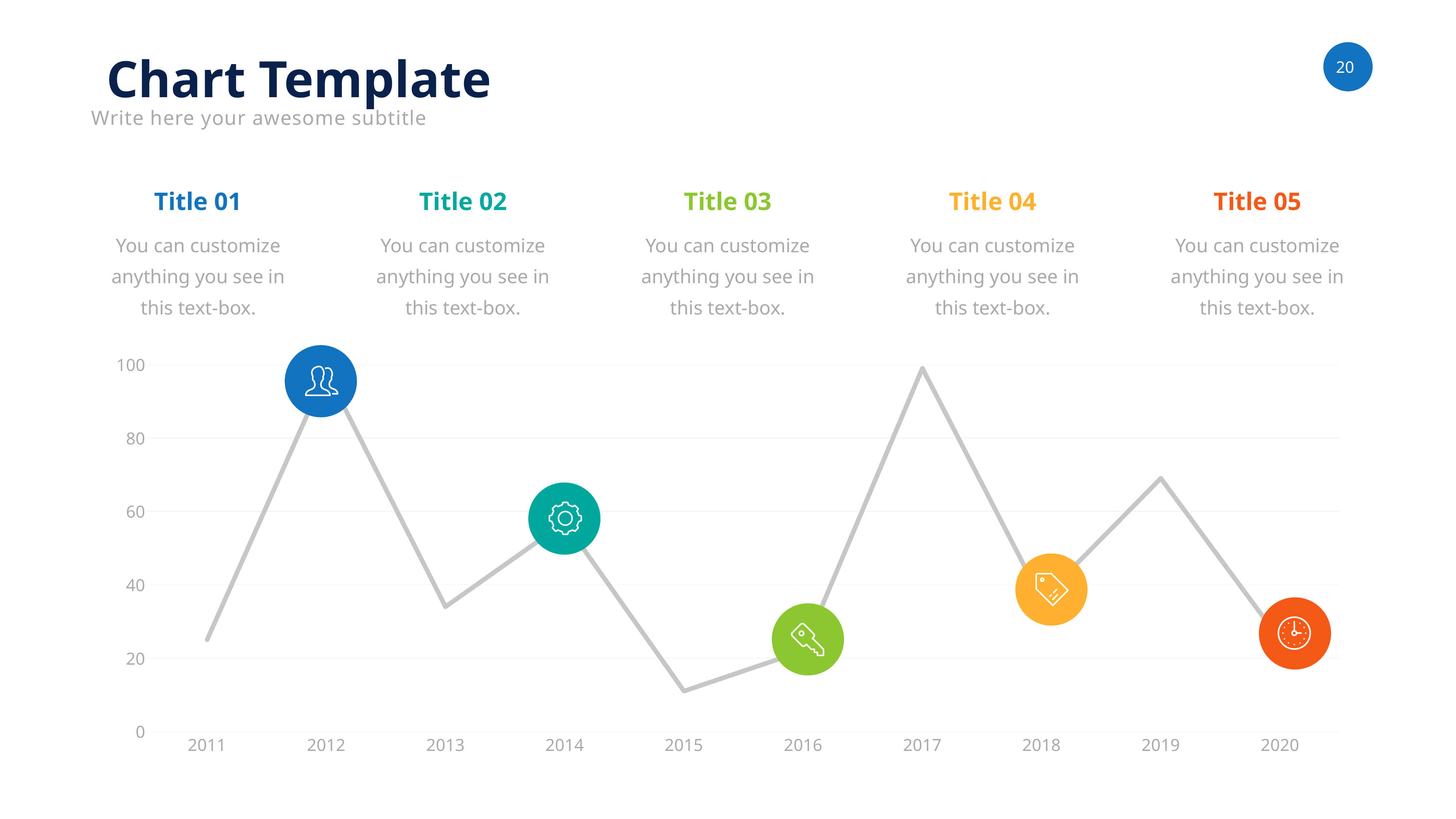
Which is larger, the value for 2017 or the value for 2019? 2017 Does the line rise or fall from 2011 to 2012? rise Is the value for 2019 greater or less than 60? greater Which is larger, the value for 2013 or the value for 2015? 2013 What kind of chart is shown on the slide? line chart Does the line rise or fall from 2017 to 2018? fall Which year has the lowest value on the chart? 2015 Is the value for 2015 greater or less than 20? less How many years are labelled along the x axis of the chart? 10 Is the value for 2013 greater or less than 40? less What is the title of the slide containing the chart? Chart Template